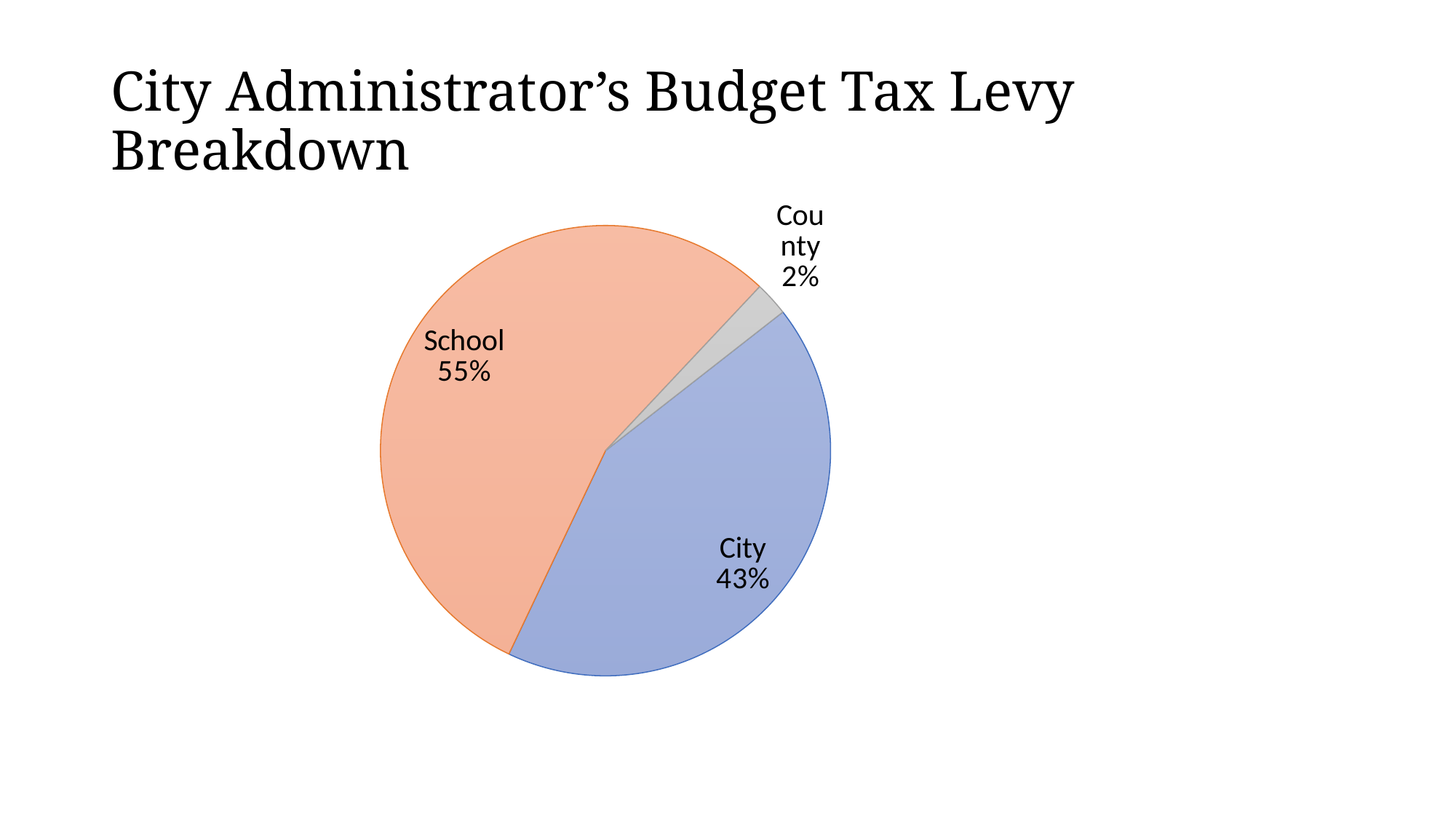
What colour is the School slice? Orange What is the difference in percentage points between the School and City shares? 12 How many slices does the pie chart have? 3 Which category has the smallest share of the pie? County What is the title of the slide containing the pie chart? City Administrator's Budget Tax Levy Breakdown What share of the tax levy goes to County? 2% Which category has the largest share of the pie? School Which is larger, the City share or the County share? City What is the difference in percentage points between the City and County shares? 41 What share of the tax levy goes to School? 55% What type of chart is shown on the slide? Pie chart What share of the tax levy goes to City? 43%